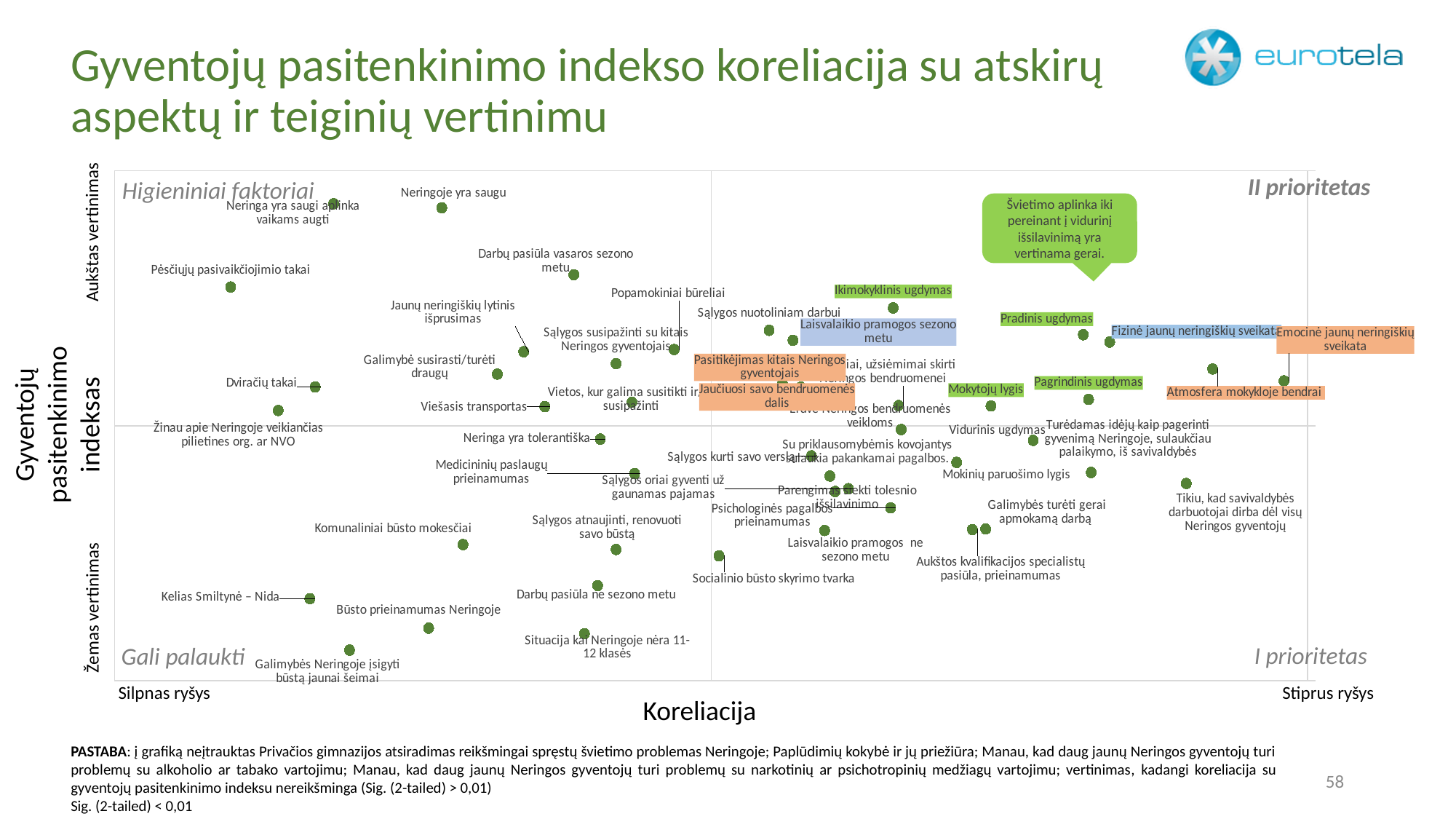
Which labelled point is plotted lowest on the vertical axis (lowest satisfaction rating)? Galimybės Neringoje įsigyti būstą jaunai šeimai Which labelled point is plotted furthest to the left (weakest correlation)? Pėsčiųjų pasivaikščiojimo takai Which point is plotted higher on the vertical axis: "Darbų pasiūla vasaros sezono metu" or "Darbų pasiūla ne sezono metu"? Darbų pasiūla vasaros sezono metu Which labelled point is plotted furthest to the right (strongest correlation)? Emocinė jaunų neringiškių sveikata What kind of chart is shown on the slide? Scatter plot Which point is plotted higher on the vertical axis: "Ikimokyklinis ugdymas" or "Socialinio būsto skyrimo tvarka"? Ikimokyklinis ugdymas Which point is plotted further to the left: "Komunaliniai būsto mokesčiai" or "Mokinių paruošimo lygis"? Komunaliniai būsto mokesčiai What is the label of the horizontal axis of the chart? Koreliacija What is the label of the vertical axis of the chart? Gyventojų pasitenkinimo indeksas Which labelled point is plotted highest on the vertical axis (highest satisfaction rating)? Neringa yra saugi aplinka vaikams augti